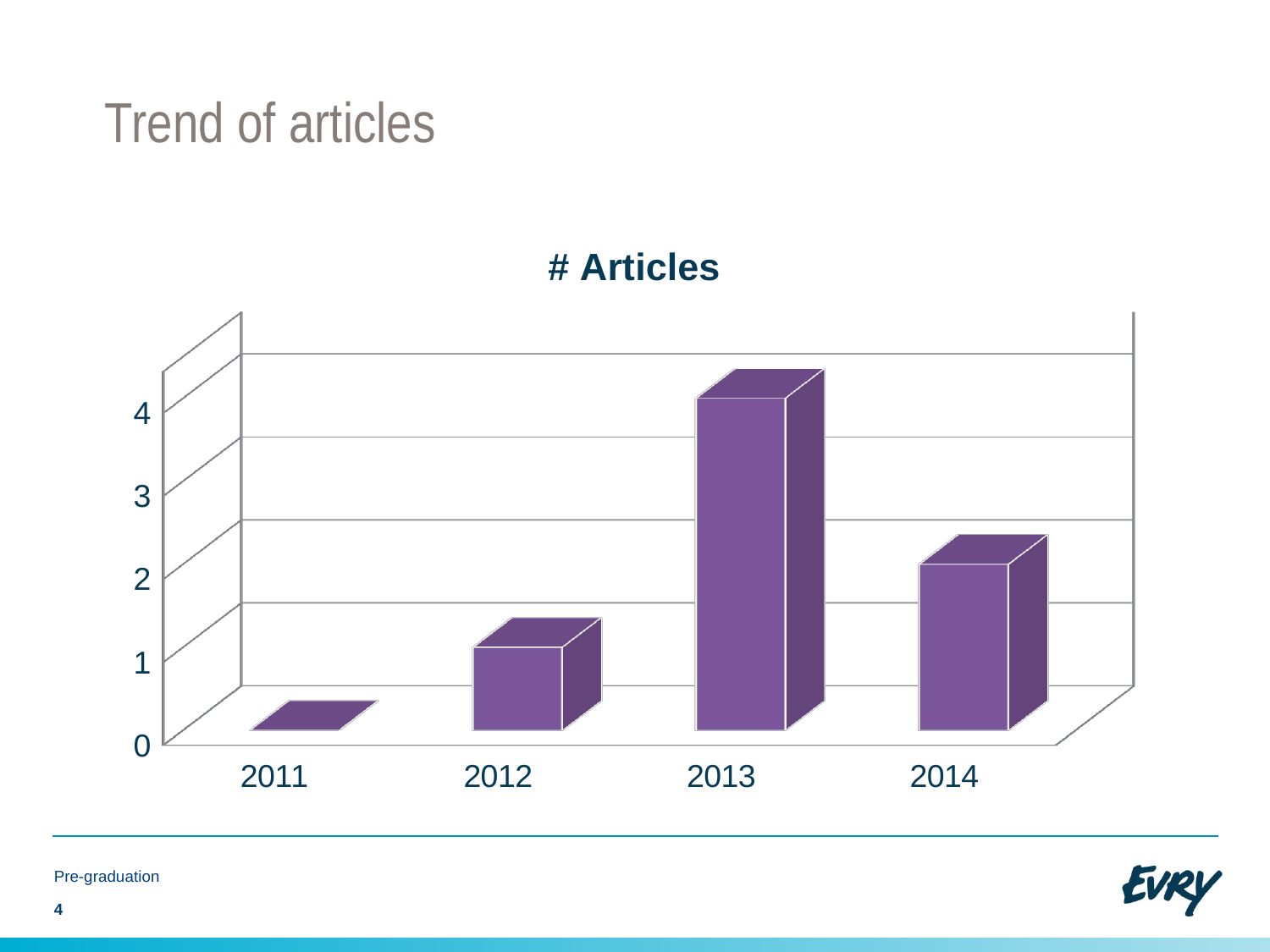
How many years are shown on the x axis of the chart? 4 Which year has more articles, 2014 or 2012? 2014 Which year has the highest number of articles? 2013 What is the number of articles for 2011? 0 What is the number of articles for 2013? 4 What is the number of articles for 2012? 1 What is the number of articles for 2014? 2 Is the value for 2013 greater or less than 3? greater What kind of chart is shown on the slide? bar chart What is the title of the chart? # Articles Which year has the lowest number of articles? 2011 Does the number of articles rise or fall from 2013 to 2014? fall